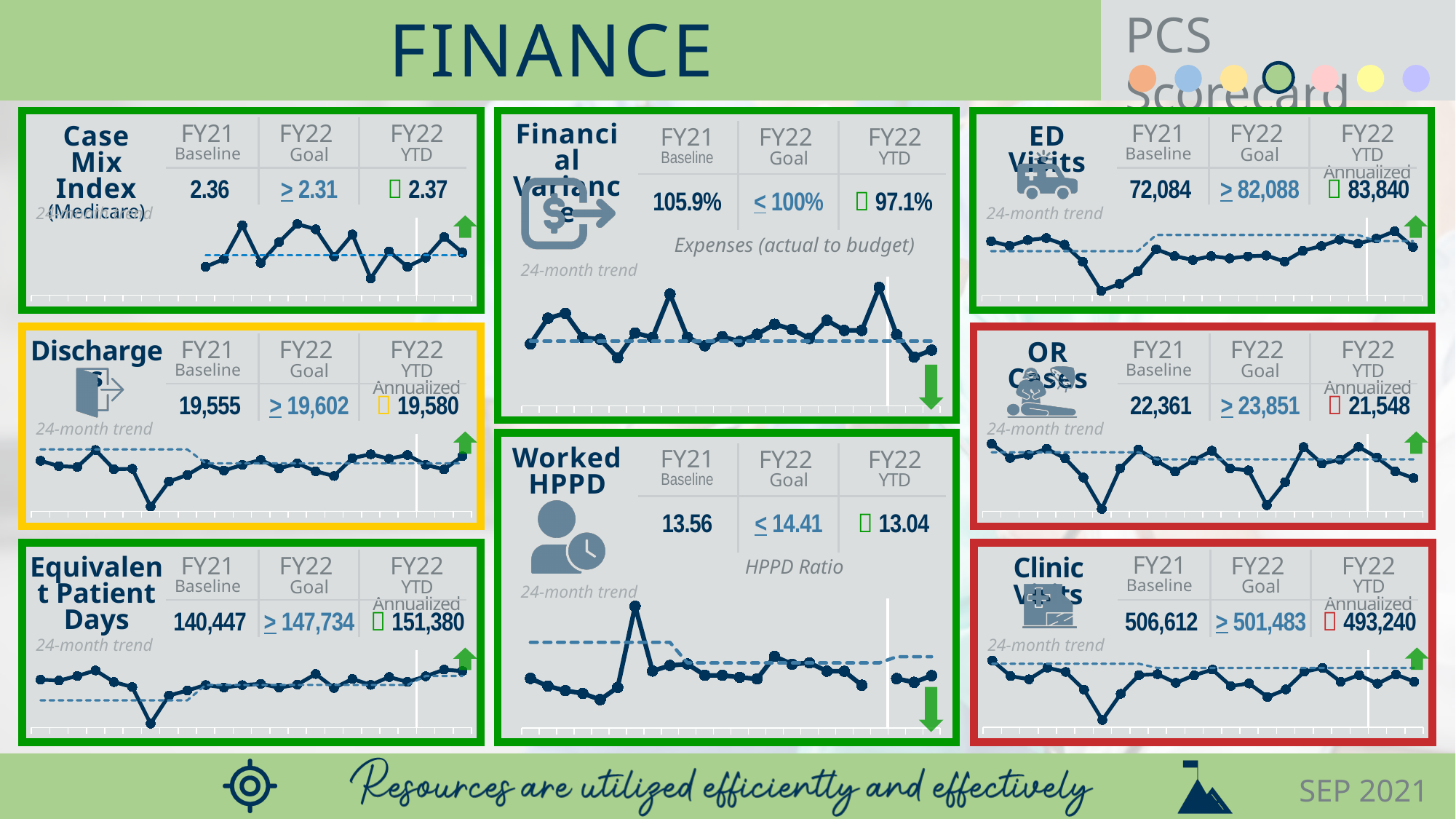
In the Case Mix Index panel, what is the FY21 Baseline value? 2.36 Which two panels on the slide have red borders? OR Cases and Clinic Visits What kind of chart is the 24-month trend in the Discharges panel? Line chart In the Financial Variance panel, what is the FY22 YTD value? 97.1% In the OR Cases panel, which is larger: the FY22 Goal or the FY22 YTD Annualized value? FY22 Goal In the ED Visits panel, what is the FY22 Goal? ≥ 82,088 In the Worked HPPD panel, what is the FY22 Goal? ≤ 14.41 In the Clinic Visits panel, what is the difference between the FY21 Baseline and the FY22 YTD Annualized value? 13,372 In the Discharges panel, what is the difference between the FY22 Goal and the FY21 Baseline? 47 In the Clinic Visits panel, what is the FY21 Baseline value? 506,612 How many metric panels with 24-month trend charts are shown on the slide? 8 In the Equivalent Patient Days panel, what is the difference between the FY22 YTD Annualized value and the FY21 Baseline? 10,933